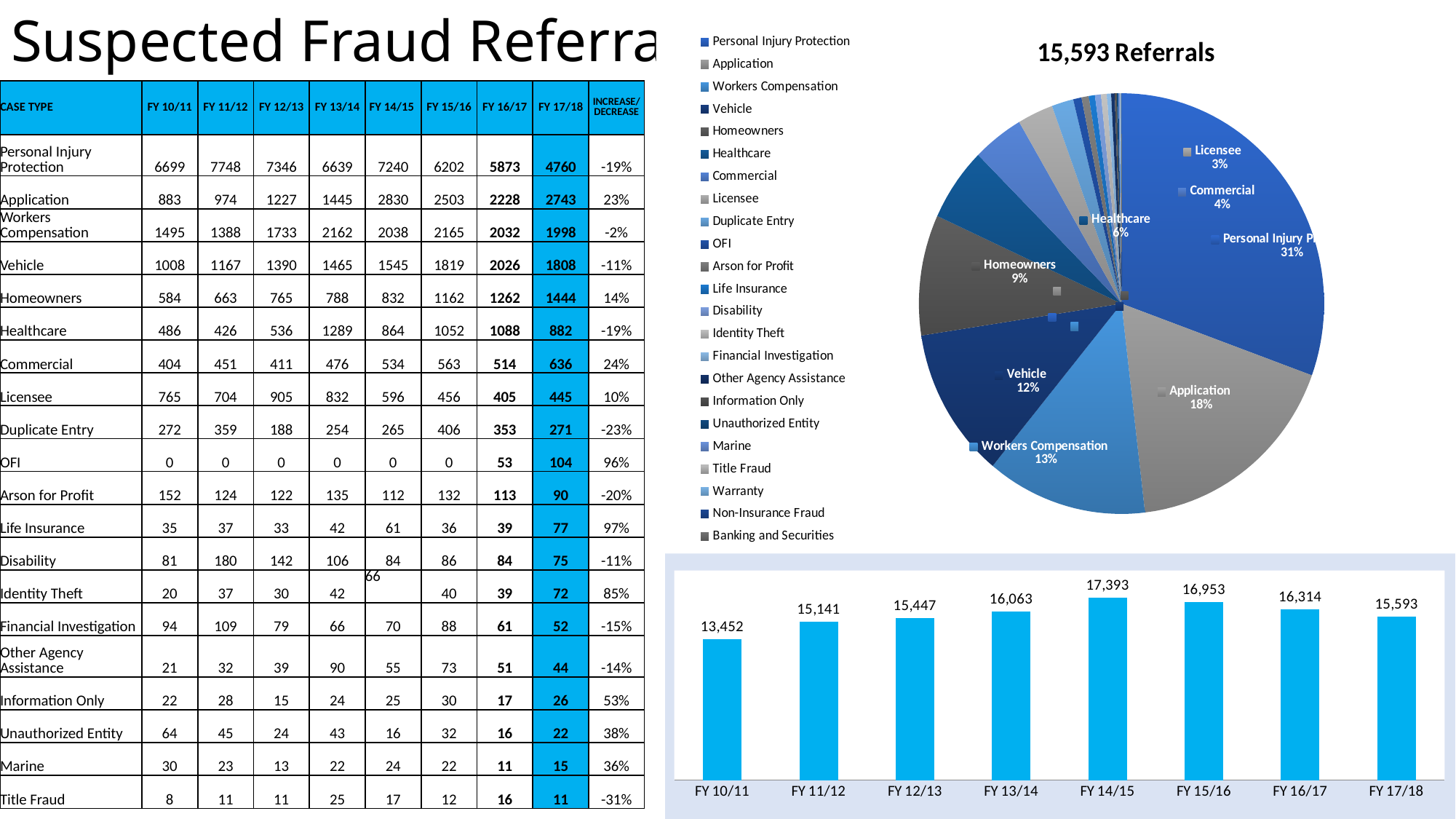
In the pie chart titled '15,593 Referrals', which category has the largest slice? Personal Injury Protection What kind of chart is shown at the bottom right of the slide? bar chart In the bar chart at the bottom right, what is the value for FY 14/15? 17,393 In the bar chart at the bottom right, which is larger, the value for FY 15/16 or FY 16/17? FY 15/16 In the bar chart at the bottom right, what is the difference between the values for FY 14/15 and FY 17/18? 1,800 How many fiscal years are shown in the bar chart at the bottom right? 8 In the pie chart titled '15,593 Referrals', what share does Application have? 18% In the bar chart at the bottom right, do the values rise or fall from FY 14/15 to FY 17/18? fall In the bar chart at the bottom right, which fiscal year has the highest value? FY 14/15 In the pie chart titled '15,593 Referrals', what share does Workers Compensation have? 13% In the bar chart at the bottom right, what is the value for FY 10/11? 13,452 In the bar chart at the bottom right, which fiscal year has the lowest value? FY 10/11